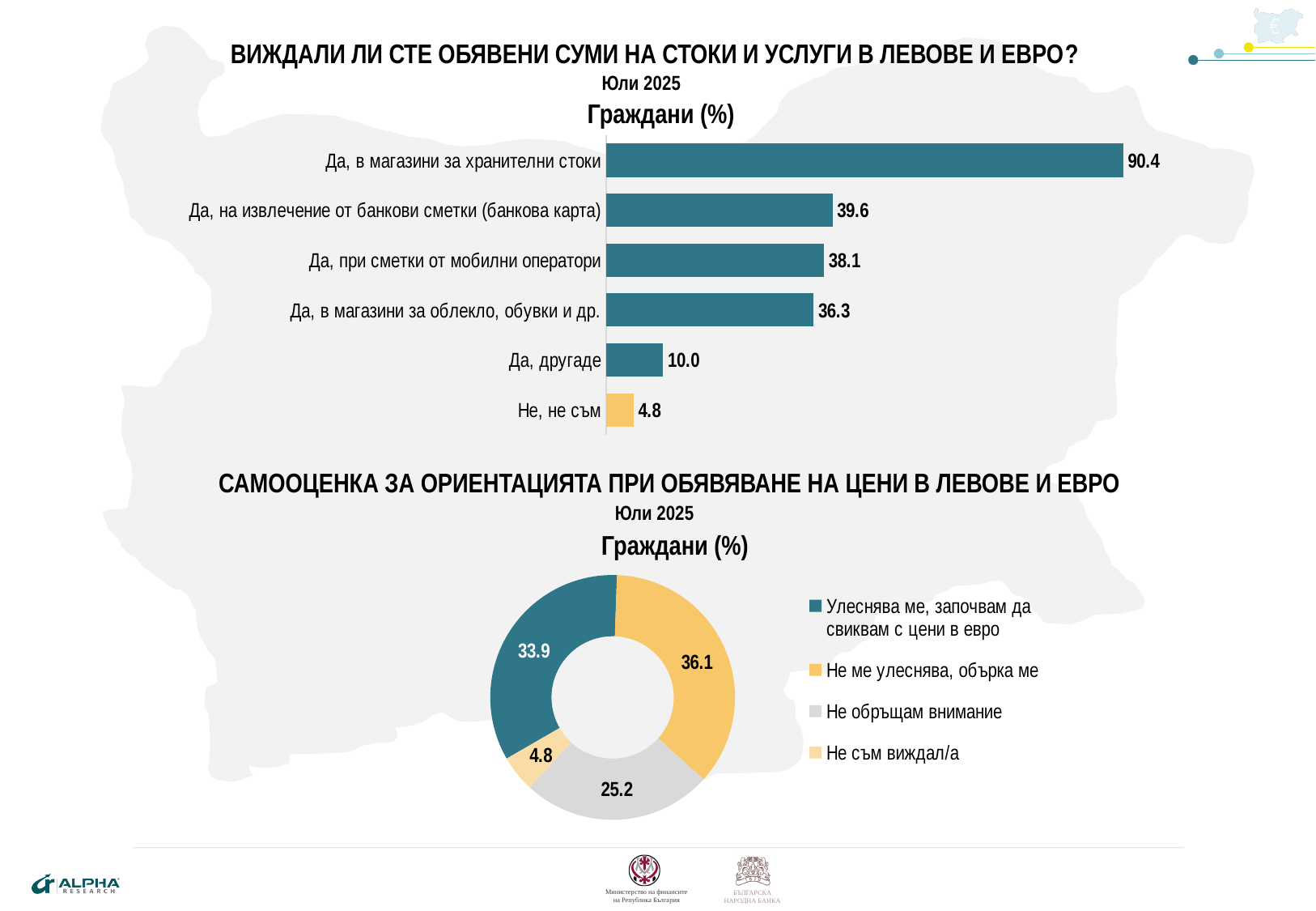
In the top chart, which category has the highest value? Да, в магазини за хранителни стоки In the top chart, which category has the lowest value? Не, не съм In the bottom chart, which category has the largest share? Не ме улеснява, обърка ме In the top chart, which is larger: 'Да, в магазини за облекло, обувки и др.' or 'Да, другаде'? Да, в магазини за облекло, обувки и др. In the bottom chart (САМООЦЕНКА ЗА ОРИЕНТАЦИЯТА...), what is the value for 'Не обръщам внимание'? 25.2 How many entries does the legend of the bottom chart list? 4 In the top chart, what is the value for 'Да, при сметки от мобилни оператори'? 38.1 What kind of chart is the bottom chart? Doughnut (pie) chart In the top chart, what is the difference between 'Да, в магазини за хранителни стоки' and 'Да, на извлечение от банкови сметки (банкова карта)'? 50.8 What kind of chart is the top chart? Bar chart How many categories does the top chart show? 6 In the top chart (ВИЖДАЛИ ЛИ СТЕ ОБЯВЕНИ СУМИ...), what is the value for 'Да, в магазини за хранителни стоки'? 90.4